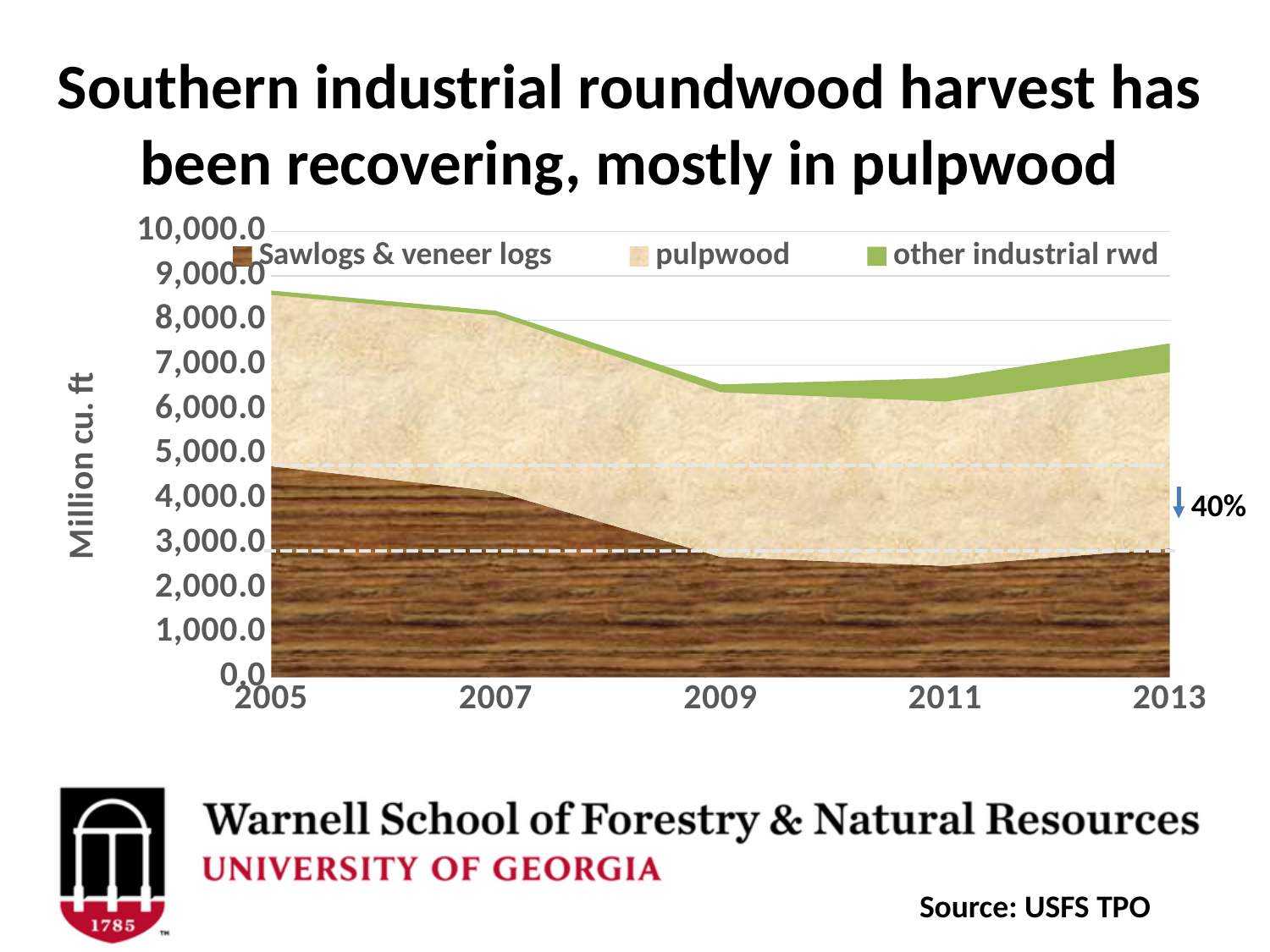
How many years are labeled on the x axis? 5 Which series is shown at the bottom of the stack? Sawlogs & veneer logs How many series does the legend list? 3 Which year has the highest total harvest? 2005 Is the total harvest in 2013 greater or less than 7,000? greater Is the total harvest in 2009 greater or less than 7,000? less Is the value for Sawlogs & veneer logs in 2005 greater or less than 4,000? greater What is the label on the y axis? Million cu. ft What kind of chart is shown on the slide? Stacked area chart Does the Sawlogs & veneer logs value rise or fall from 2005 to 2011? fall